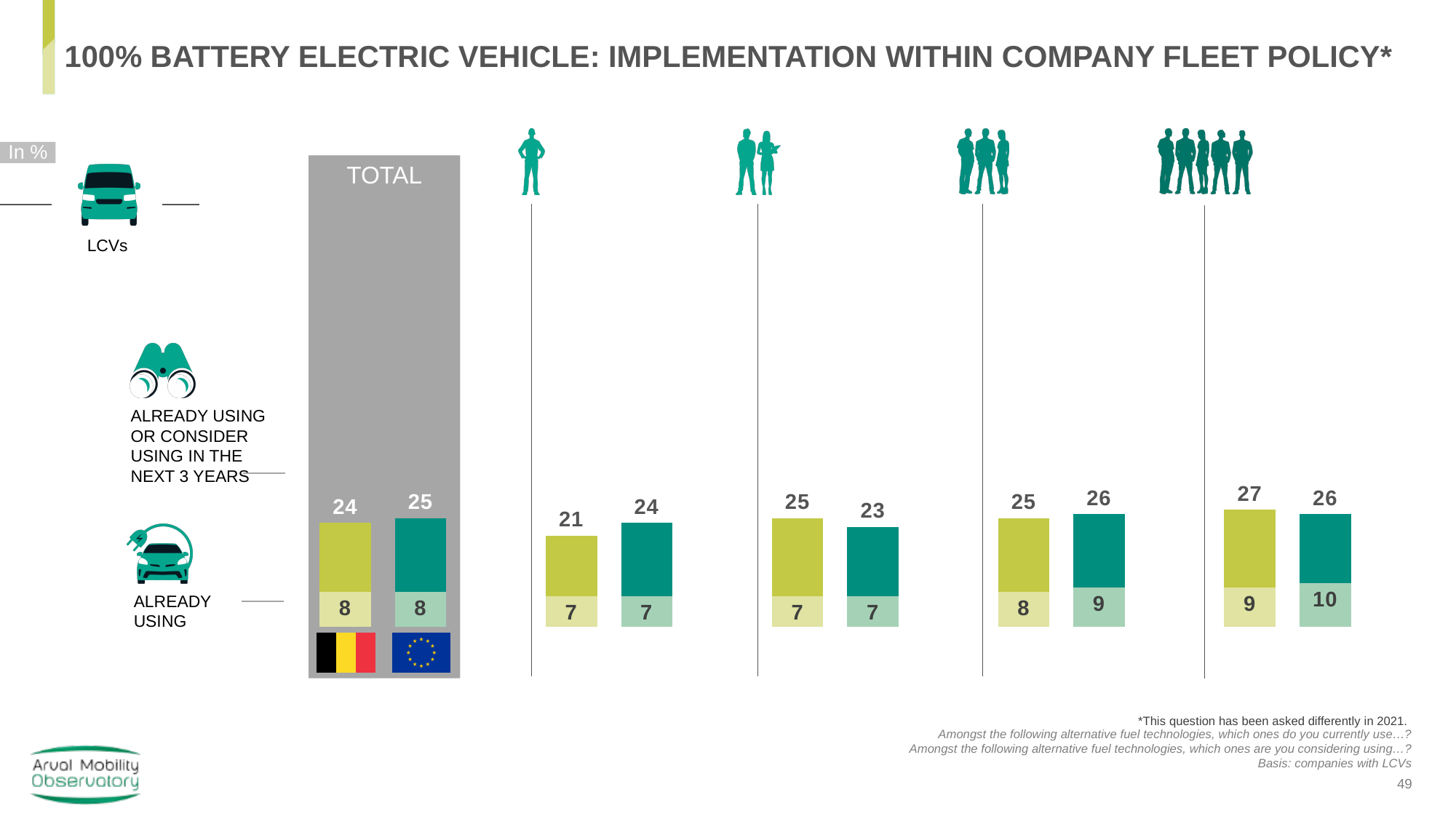
Which flag is shown beneath the teal bars in the TOTAL column? The EU flag For the smallest company-size group (single person icon), what is the Belgian value for already using or consider using 100% battery electric vehicles? 21 How many company-size groups are shown in addition to the TOTAL column? 4 In the TOTAL column, what percentage of Belgian companies with LCVs are already using or consider using 100% battery electric vehicles in the next 3 years? 24 In the TOTAL column, what is the difference between the European and Belgian values for already using or consider using 100% battery electric vehicles? 1 In what unit are the values on this chart expressed? % For the largest company-size group (five people icon), what is the European value for already using 100% battery electric vehicles? 10 In the TOTAL column, what percentage of European companies with LCVs are already using 100% battery electric vehicles? 8 For the second company-size group (two people icon), which is larger for already using or consider using: the Belgian value or the European value? Belgian value (25 vs 23) Across the four company-size groups, which group has the lowest Belgian value for already using or consider using 100% battery electric vehicles? The smallest company-size group (single person icon), 21 What kind of chart is used on this slide? Bar chart Across the four company-size groups, which group has the highest Belgian value for already using or consider using 100% battery electric vehicles? The largest company-size group (five people icon), 27